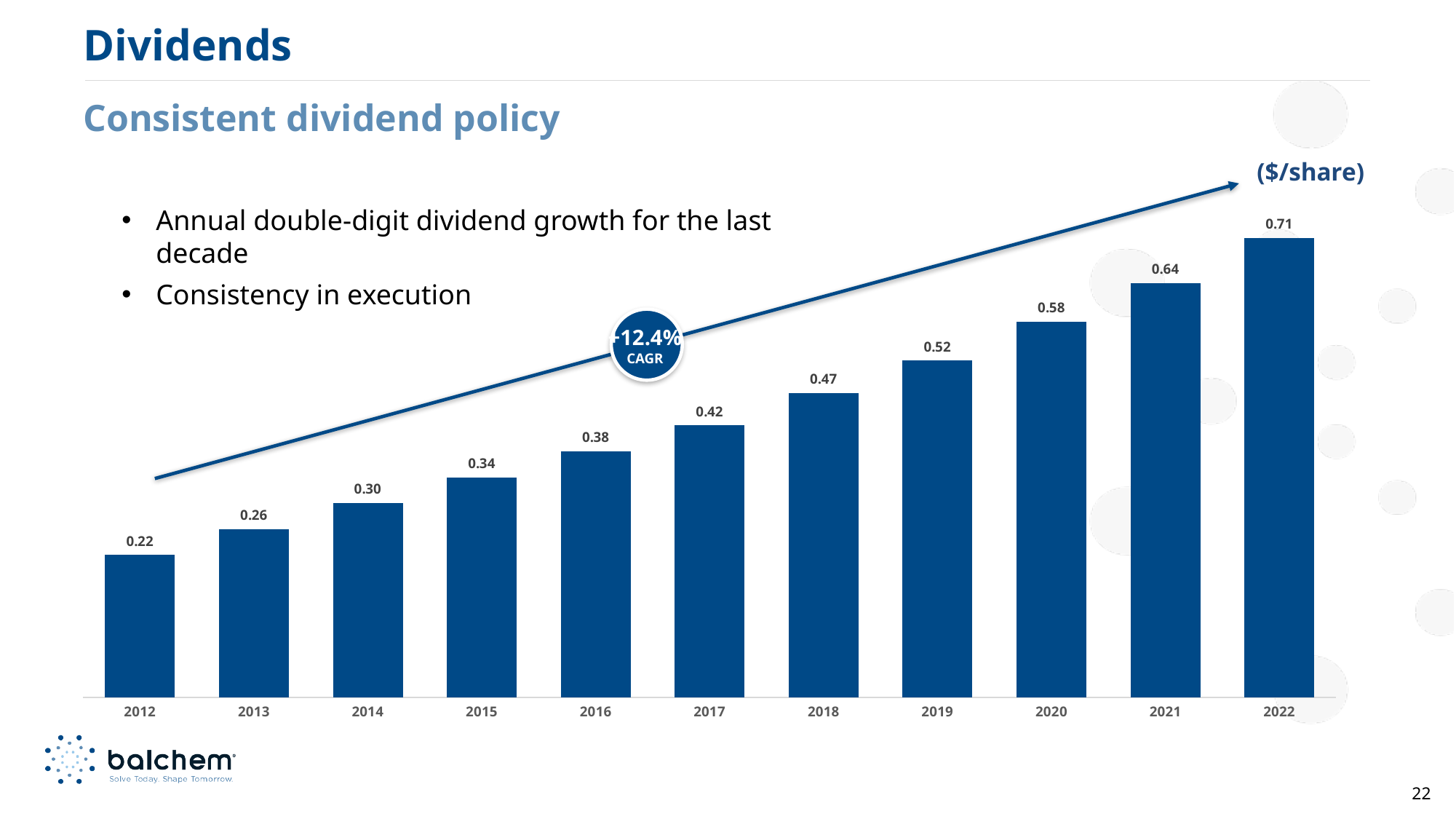
What is the difference between the dividend per share in 2021 and in 2020? 0.06 What is the dividend per share value shown for 2022? 0.71 What is the dividend per share value shown for 2018? 0.47 What is the dividend per share value shown for 2012? 0.22 How many years are shown on the x axis of the chart? 11 Do the dividend per share values rise or fall from 2012 to 2022? Rise What is the difference between the dividend per share in 2022 and in 2012? 0.49 Which year has a larger dividend per share, 2016 or 2019? 2019 What kind of chart is shown on the slide? Bar chart Which year has the lowest dividend per share on the chart? 2012 What CAGR is shown in the circle on the chart? ~12.4% Which year has the highest dividend per share on the chart? 2022